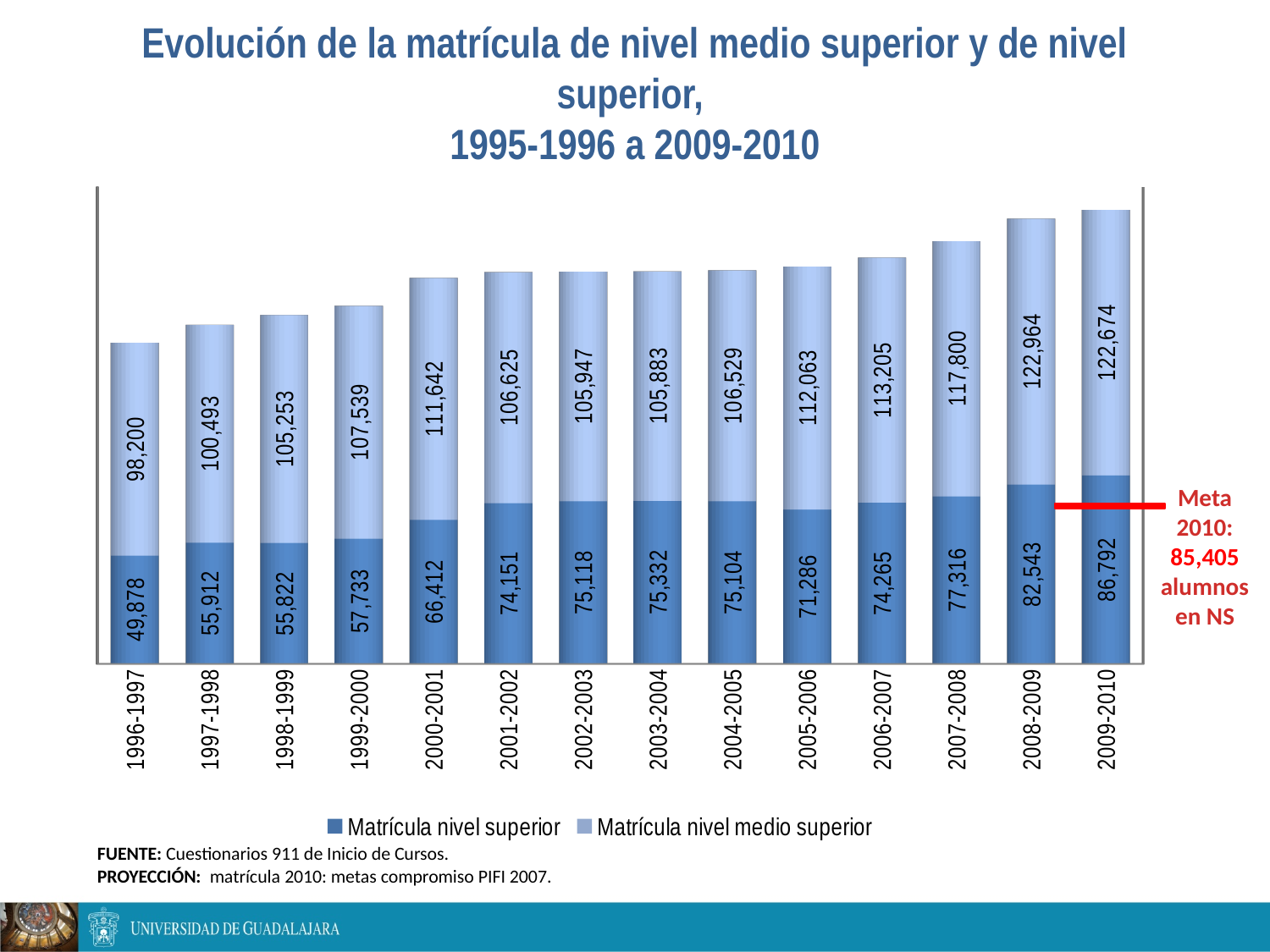
What is the value of Matrícula nivel superior for 1996-1997? 49,878 What kind of chart is shown on the slide? Stacked bar chart What is the difference between Matrícula nivel superior in 2009-2010 and in 2008-2009? 4,249 Which year has the highest value for Matrícula nivel superior? 2009-2010 What is the value of Matrícula nivel medio superior for 2009-2010? 122,674 How many academic years are shown on the x axis? 14 Which year has the lowest value for Matrícula nivel medio superior? 1996-1997 What is the Meta 2010 value for alumnos en NS shown next to the chart? 85,405 What is the total enrolment (both series combined) for 2009-2010? 209,466 Which is larger: Matrícula nivel medio superior in 2008-2009 or in 2009-2010? 2008-2009 What is the value of Matrícula nivel superior for 2005-2006? 71,286 How many series does the legend list? 2